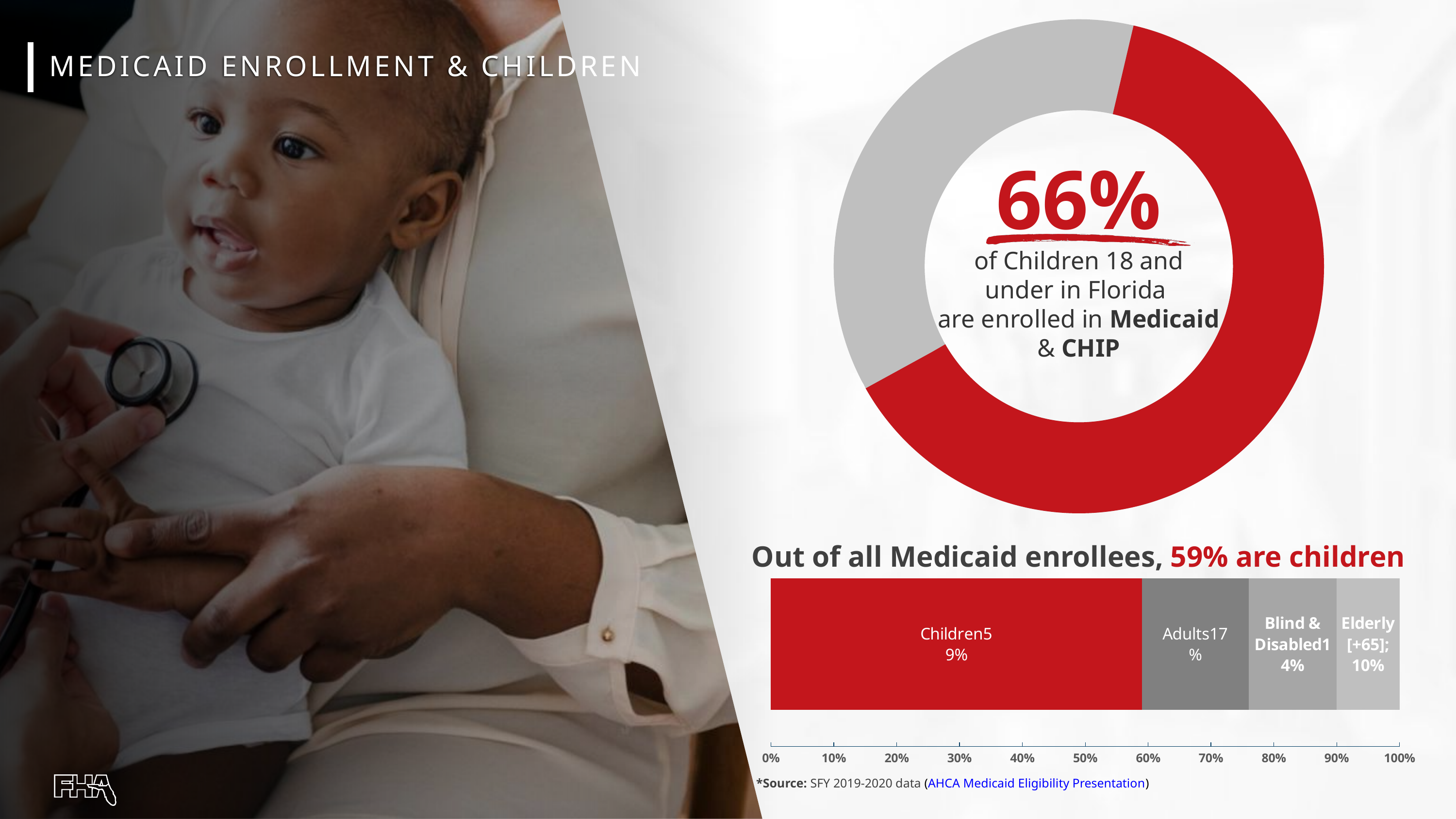
In the bar chart of Medicaid enrollees, what share are Children? 59% What kind of chart is the chart at the bottom right of the slide showing Medicaid enrollees? bar chart What kind of chart is the chart at the top right of the slide showing 66%? donut chart In the bar chart of Medicaid enrollees, what share are Blind & Disabled? 14% In the bar chart of Medicaid enrollees, which is larger: the Adults share or the Blind & Disabled share? Adults In the bar chart of Medicaid enrollees, which group has the largest share? Children In the bar chart of Medicaid enrollees, what share are Adults? 17% In the bar chart of Medicaid enrollees, which group has the smallest share? Elderly [+65] In the bar chart of Medicaid enrollees, what share are Elderly [+65]? 10% In the donut chart, what percentage of children 18 and under in Florida are enrolled in Medicaid & CHIP? 66% In the bar chart of Medicaid enrollees, how many percentage points larger is the Children share than the Adults share? 42% How many enrollee groups are shown in the stacked bar chart at the bottom of the slide? 4